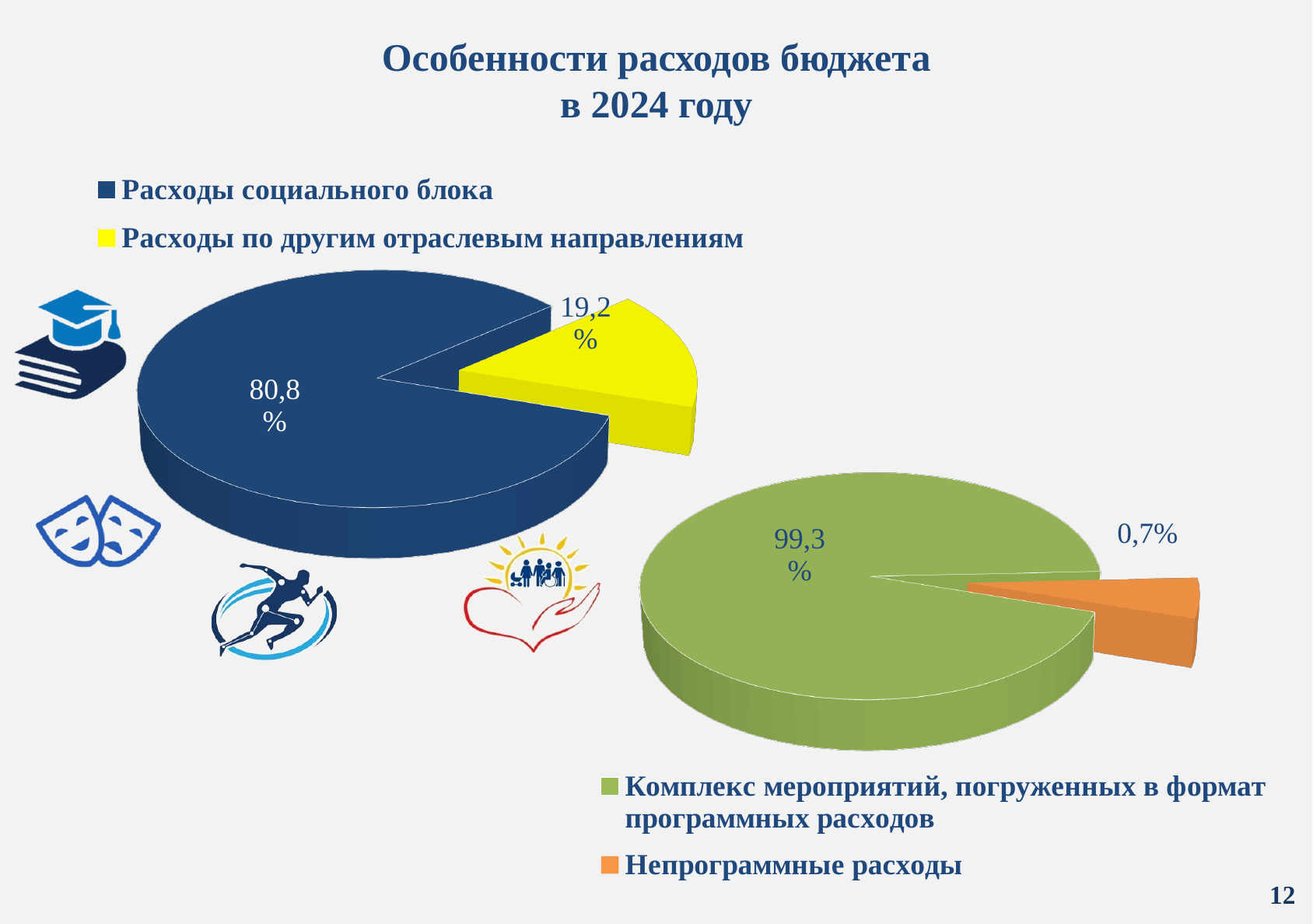
In the lower-right pie chart, what is the difference in percentage points between the two slices? 98,6 In the upper-left pie chart, what is the difference in percentage points between Расходы социального блока and Расходы по другим отраслевым направлениям? 61,6 In the lower-right pie chart, what share is shown for Комплекс мероприятий, погруженных в формат программных расходов? 99,3% How many slices does the lower-right pie chart have? 2 In the lower-right pie chart, what share is shown for Непрограммные расходы? 0,7% In the upper-left pie chart, what share is shown for Расходы социального блока? 80,8% In the lower-right pie chart, which category has the smallest slice? Непрограммные расходы What type of chart is the upper-left chart? Pie chart In the lower-right pie chart, what colour is the slice for Непрограммные расходы? Orange In the upper-left pie chart, which is larger: Расходы социального блока or Расходы по другим отраслевым направлениям? Расходы социального блока In the upper-left pie chart, which category has the largest slice? Расходы социального блока In the upper-left pie chart, what share is shown for Расходы по другим отраслевым направлениям? 19,2%